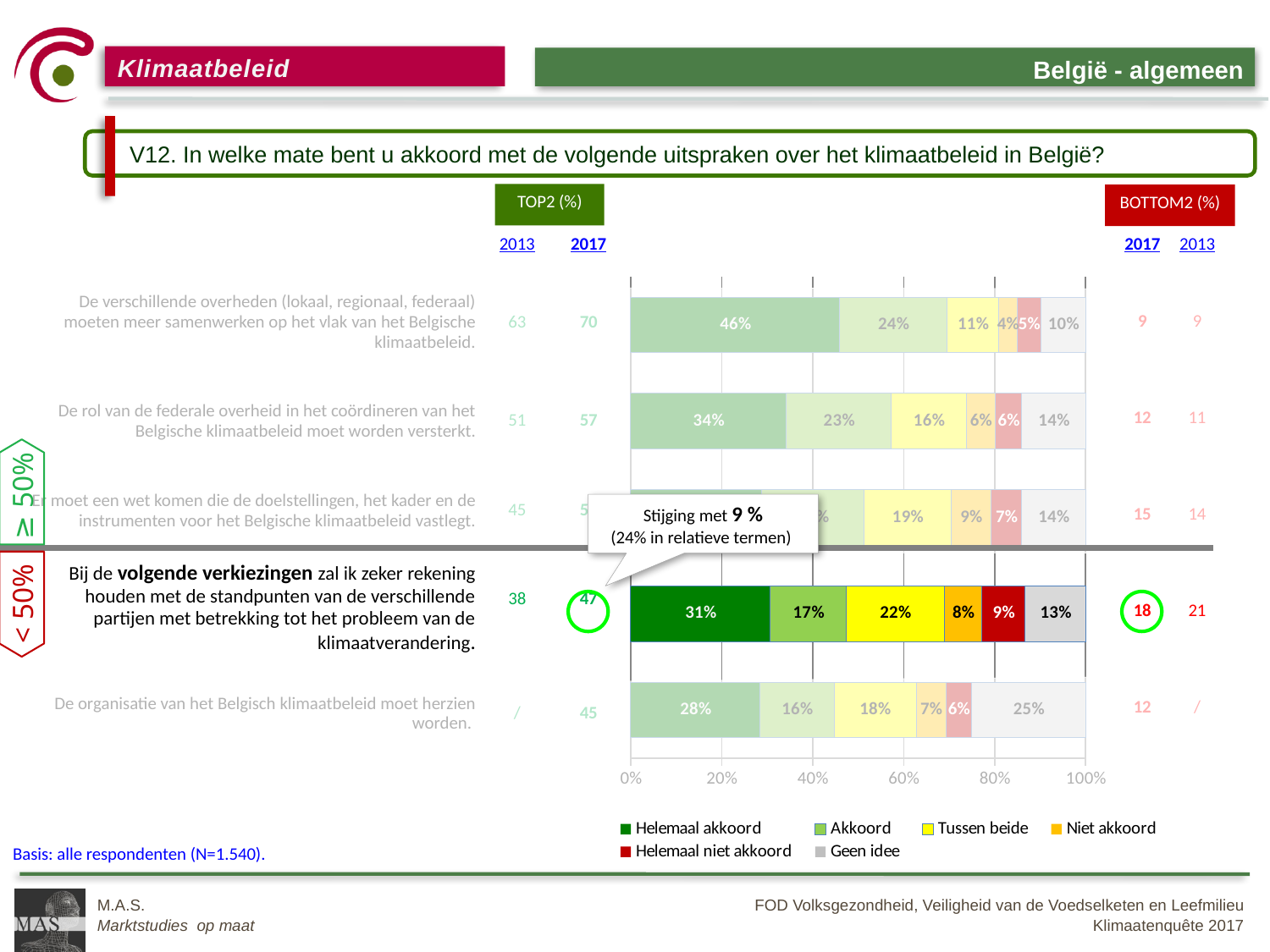
What kind of chart is shown on the slide? Stacked bar chart What is the 'Geen idee' value for the statement 'De organisatie van het Belgisch klimaatbeleid moet herzien worden'? 25% Which statement has the highest 'Helemaal akkoord' share? De verschillende overheden (lokaal, regionaal, federaal) moeten meer samenwerken op het vlak van het Belgische klimaatbeleid. What colour represents 'Helemaal akkoord' in the chart legend? Dark green Which statement has the lowest 'Geen idee' share? De verschillende overheden (lokaal, regionaal, federaal) moeten meer samenwerken op het vlak van het Belgische klimaatbeleid. For the statement 'Bij de volgende verkiezingen...', what is the difference between the 'Helemaal akkoord' and 'Akkoord' values? 14 percentage points What is the 'Helemaal niet akkoord' value for the statement 'Bij de volgende verkiezingen zal ik zeker rekening houden...'? 9% How many statements (bars) are plotted in the chart? 5 How many series does the chart legend list? 6 Which statement has the larger 'Geen idee' share: 'De organisatie van het Belgisch klimaatbeleid moet herzien worden' or 'Bij de volgende verkiezingen...'? De organisatie van het Belgisch klimaatbeleid moet herzien worden. What is the 'Helemaal akkoord' value for the statement 'Bij de volgende verkiezingen zal ik zeker rekening houden met de standpunten van de verschillende partijen...'? 31% What is the 'Tussen beide' value for the statement 'De rol van de federale overheid in het coördineren van het Belgische klimaatbeleid moet worden versterkt'? 16%